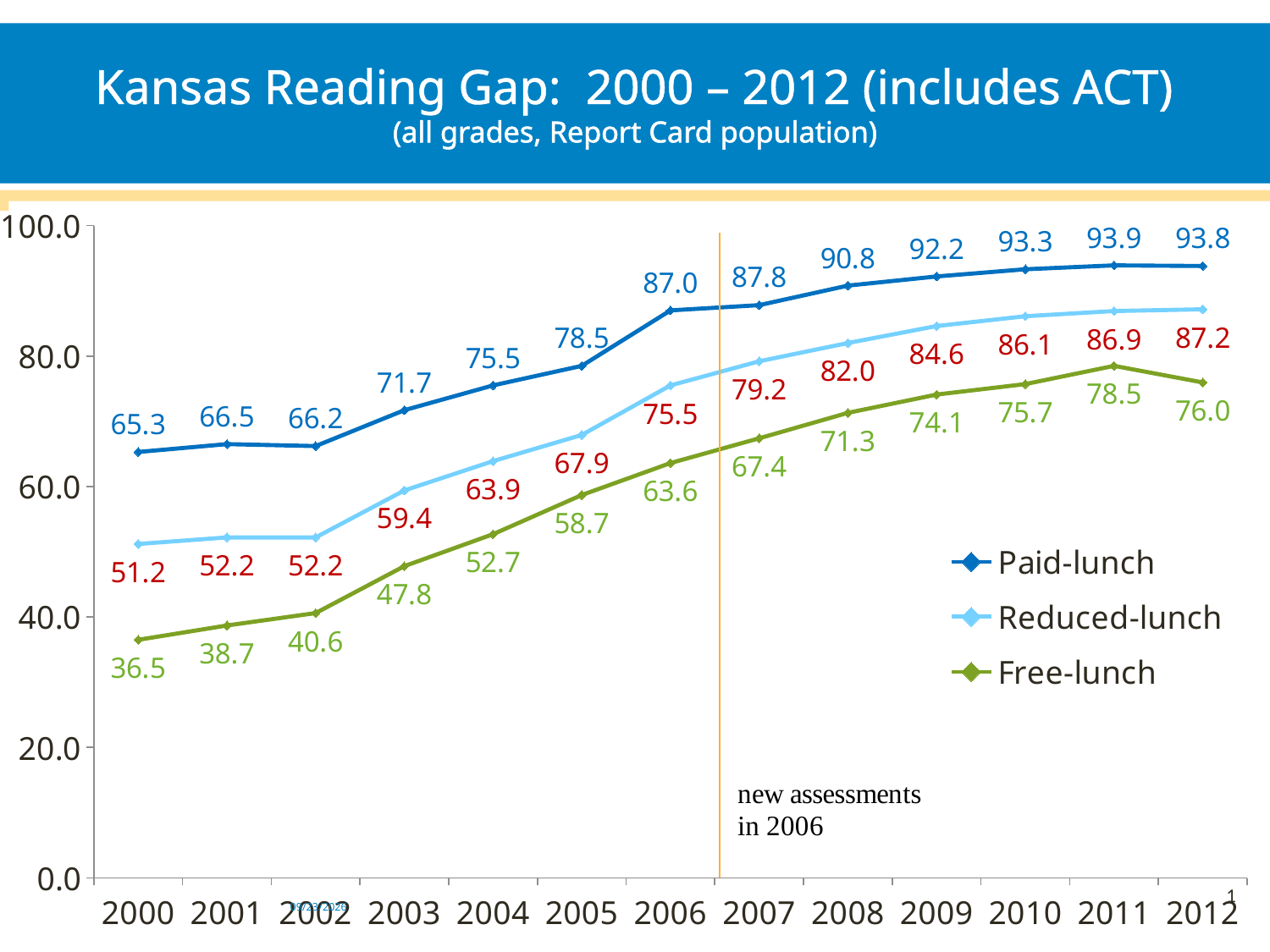
In which year is the Free-lunch value lowest? 2000 What is the Free-lunch value for 2000? 36.5 How many years are shown on the x axis? 13 What is the difference between the Free-lunch values in 2011 and 2012? 2.5 In which year is the Paid-lunch value highest? 2011 Which is larger in 2005: the Reduced-lunch value or the Free-lunch value? Reduced-lunch What is the difference between the Paid-lunch and Free-lunch values in 2000? 28.8 What is the Reduced-lunch value for 2012? 87.2 How many series does the legend list? 3 What is the Paid-lunch value for 2006? 87.0 What kind of chart is shown on the slide? Line chart Does the Reduced-lunch line generally rise or fall from 2000 to 2012? Rise